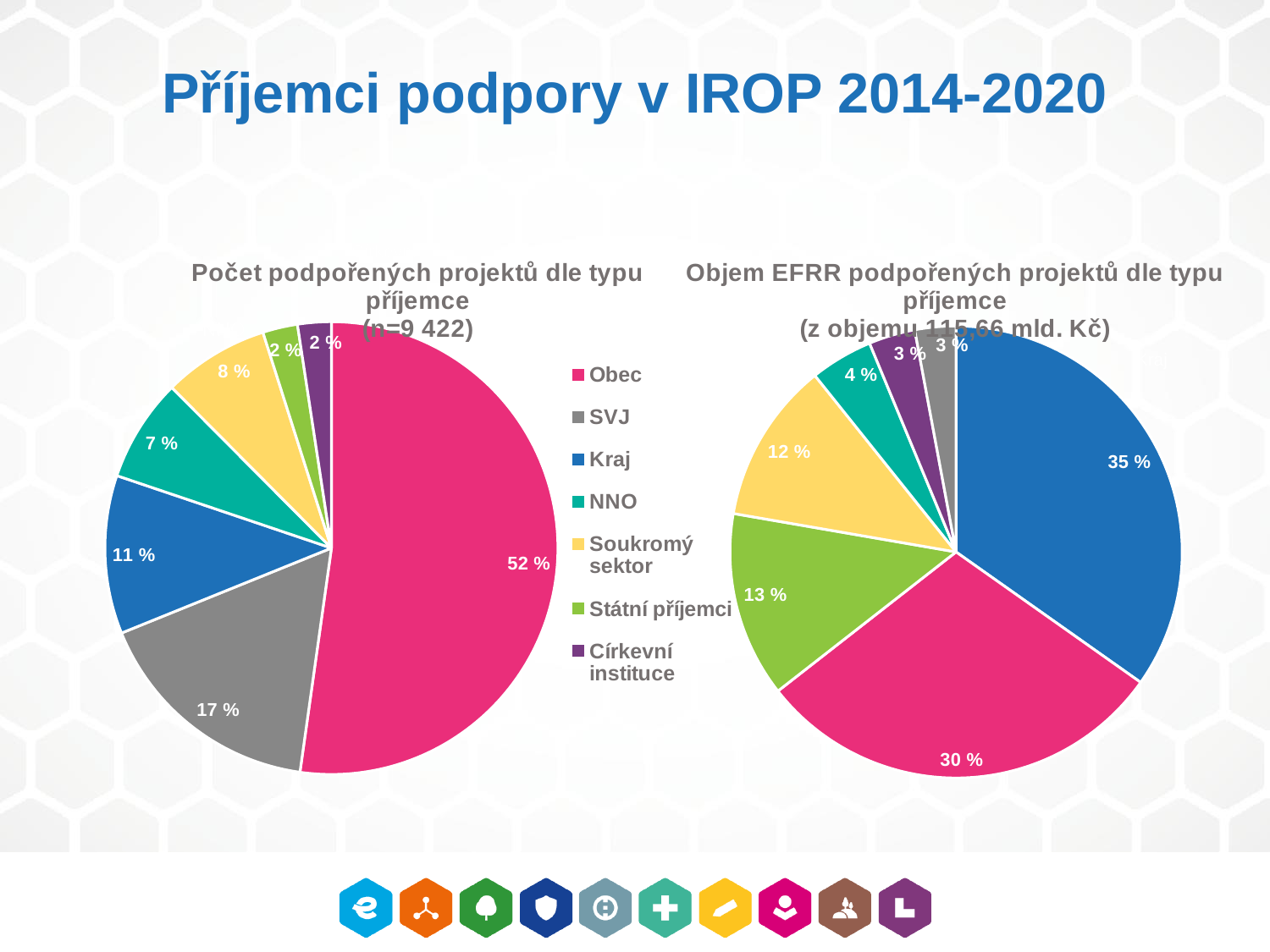
In the left chart (Počet podpořených projektů dle typu příjemce), what share of projects belongs to Obec? 52 % How many recipient types does the legend list? 7 In the left chart (Počet podpořených projektů dle typu příjemce), what is the difference between the shares of Obec and SVJ? 35 % In the right chart (Objem EFRR podpořených projektů dle typu příjemce), which recipient type has the smallest share, NNO or Soukromý sektor? NNO In the right chart (Objem EFRR podpořených projektů dle typu příjemce), what share of the EFRR volume belongs to Státní příjemci? 13 % In the right chart (Objem EFRR podpořených projektů dle typu příjemce), which recipient type has the largest share? Kraj What type of chart is used on this slide? Pie chart In the left chart (Počet podpořených projektů dle typu příjemce), what share of projects belongs to SVJ? 17 % In the right chart (Objem EFRR podpořených projektů dle typu příjemce), what is the difference between the shares of Kraj and Obec? 5 % In the left chart (Počet podpořených projektů dle typu příjemce), which recipient type has the largest share? Obec What is the total number of projects (n) stated in the title of the left chart? 9 422 In the right chart (Objem EFRR podpořených projektů dle typu příjemce), what share of the EFRR volume belongs to Kraj? 35 %